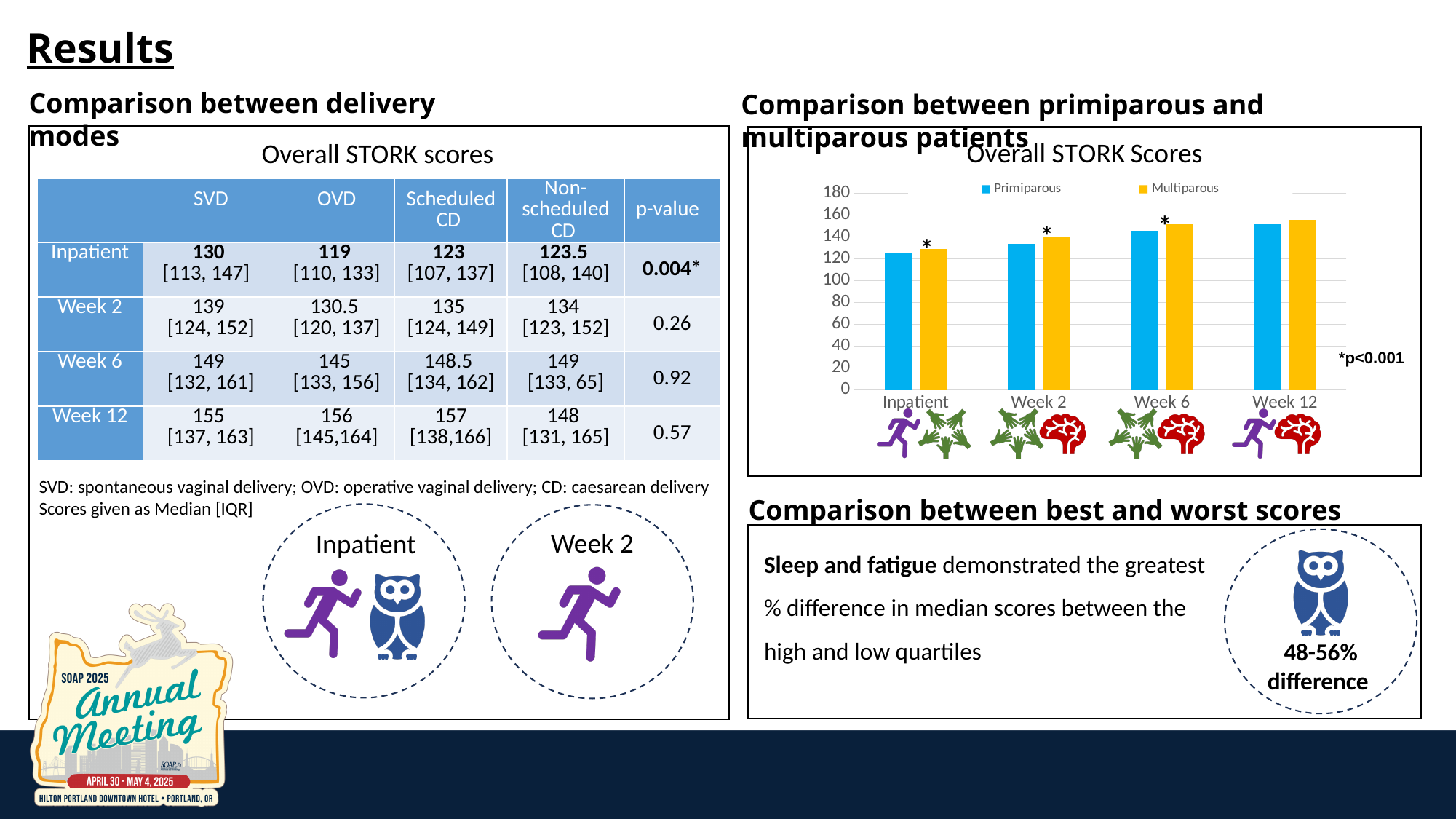
In the "Overall STORK Scores" chart, is the Primiparous value for Week 6 greater or less than 140? greater What kind of chart is the "Overall STORK Scores" chart? bar chart In the "Overall STORK Scores" chart, which time point has the highest Multiparous score? Week 12 In the "Overall STORK Scores" chart, is the Primiparous value for Inpatient greater or less than 120? greater In the "Overall STORK Scores" chart, what does the asterisk above the bars indicate according to the note? p<0.001 In the "Overall STORK Scores" chart, which time point has the lowest Primiparous score? Inpatient In the "Overall STORK Scores" chart, is the Multiparous value for Week 12 greater or less than 160? less In the "Overall STORK Scores" chart, at Week 2, which series has the larger value, Primiparous or Multiparous? Multiparous In the "Overall STORK Scores" chart, which colour represents the Multiparous series? yellow How many time-point categories are shown on the x axis of the "Overall STORK Scores" chart? 4 How many series does the legend of the "Overall STORK Scores" chart list? 2 In the "Overall STORK Scores" chart, do the Primiparous scores rise or fall from Inpatient to Week 12? rise